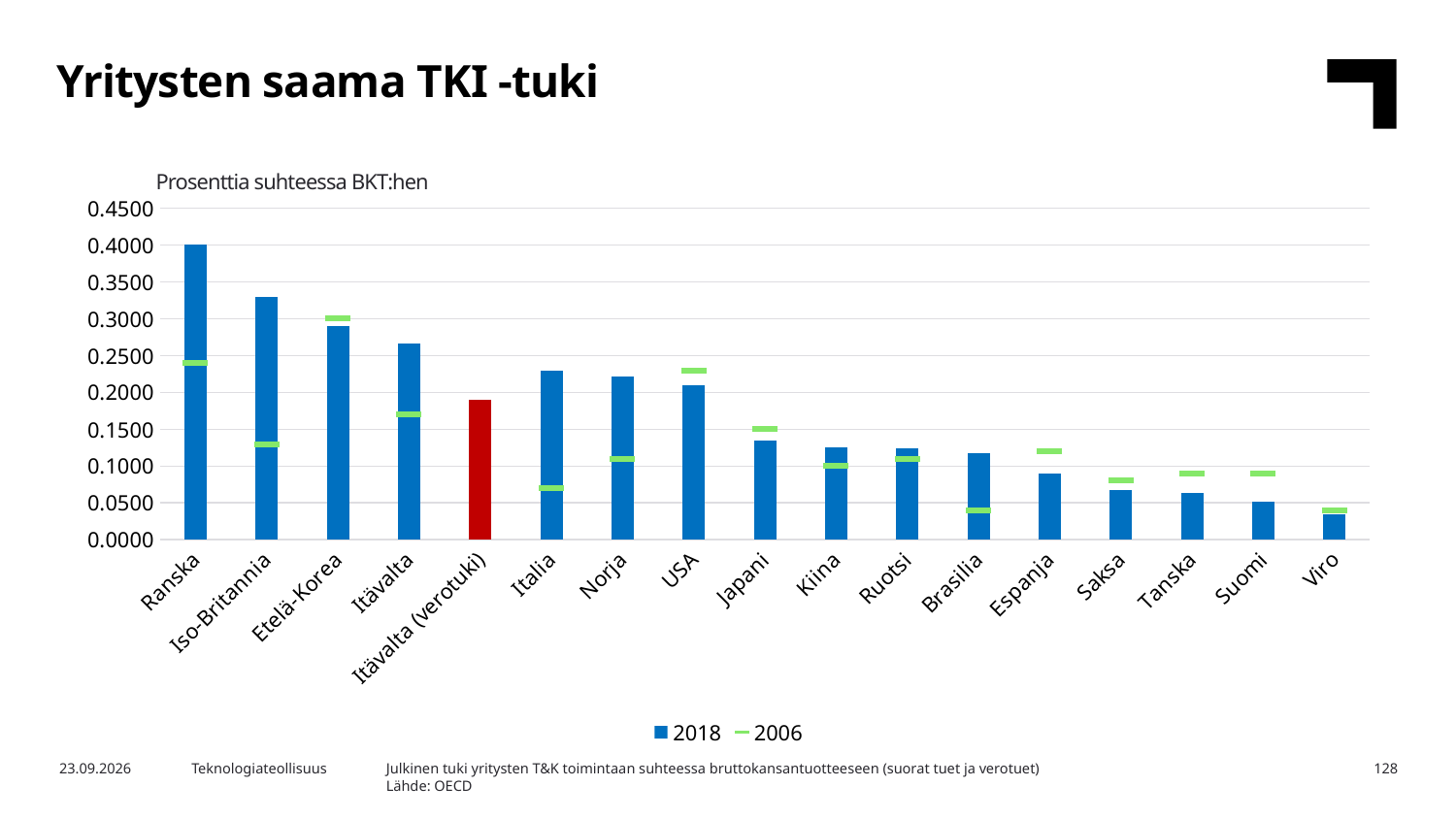
Which category has the lowest 2018 value in the chart? Viro For Ranska, which is larger, the 2018 value or the 2006 value? 2018 Which category has the highest 2018 value in the chart? Ranska How many countries/categories are shown on the x axis of the chart? 17 Is the 2018 value for Italia greater or less than 0.2000? greater Which has the larger 2018 value, Iso-Britannia or Etelä-Korea? Iso-Britannia Is the 2018 value for Suomi greater or less than 0.1000? less Which category is shown with a red bar instead of a blue one? Itävalta (verotuki) How many series does the chart legend list? 2 Is the 2018 value for Ranska greater or less than 0.3500? greater What kind of chart is shown on the slide? bar chart Do the 2018 values generally rise or fall from left to right along the x axis? fall